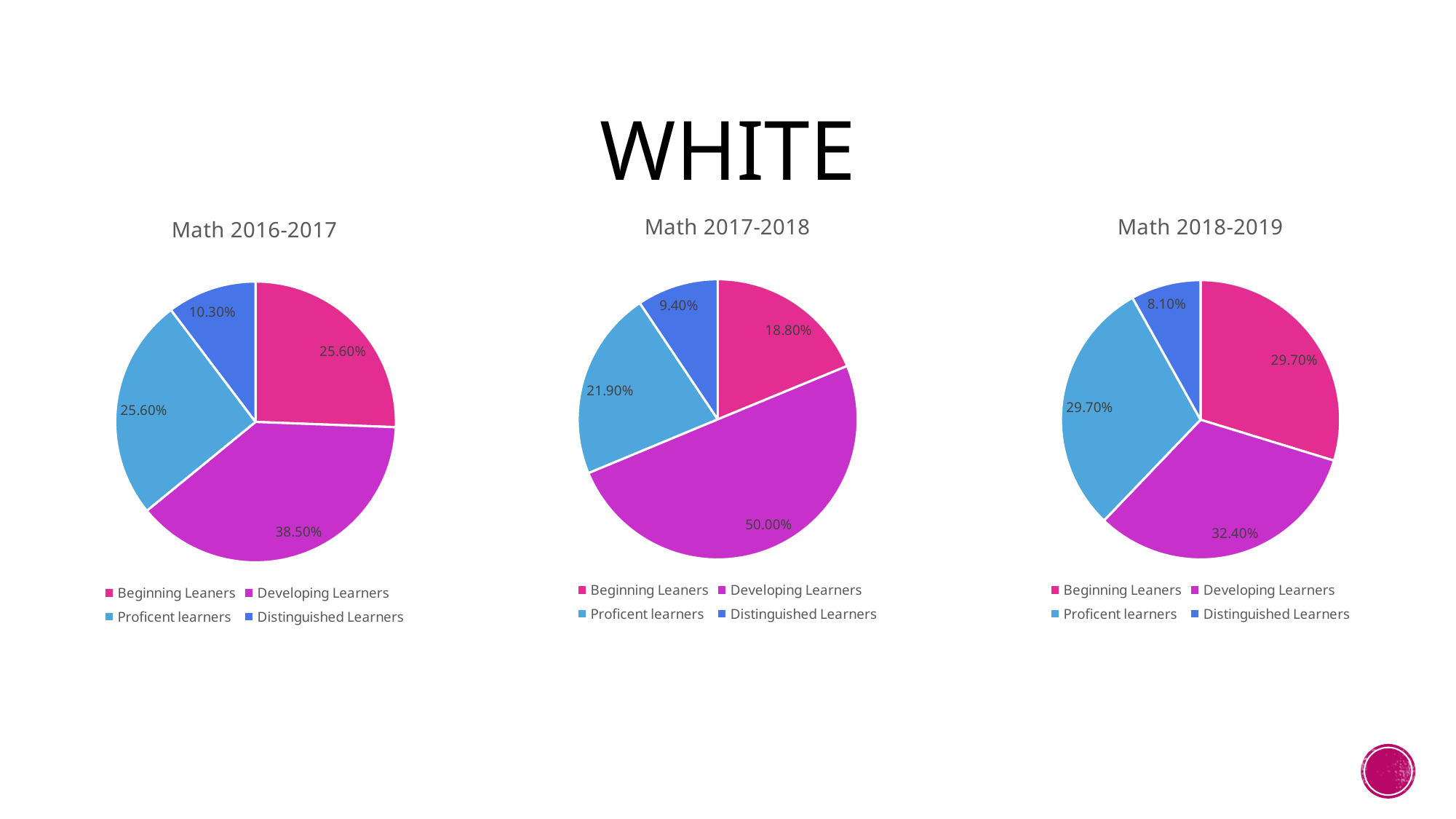
In the Math 2018-2019 chart, what is the value for Distinguished Learners? 8.10% How many slices does the Math 2018-2019 pie chart have? 4 In the Math 2017-2018 chart, what is the difference between Developing Learners and Beginning Leaners? 31.20% In the Math 2018-2019 chart, what is the difference between Developing Learners and Beginning Leaners? 2.70% In the Math 2017-2018 chart, what is the value for Proficent learners? 21.90% How many entries does the legend of the Math 2016-2017 chart list? 4 In the Math 2017-2018 chart, which category has the largest slice? Developing Learners In the Math 2016-2017 chart, which category has the smallest slice? Distinguished Learners In the Math 2016-2017 chart, what is the value for Developing Learners? 38.50% In the Math 2017-2018 chart, which is larger: Proficent learners or Beginning Leaners? Proficent learners What is the title of the leftmost chart on the slide? Math 2016-2017 What kind of chart is the Math 2017-2018 chart? Pie chart